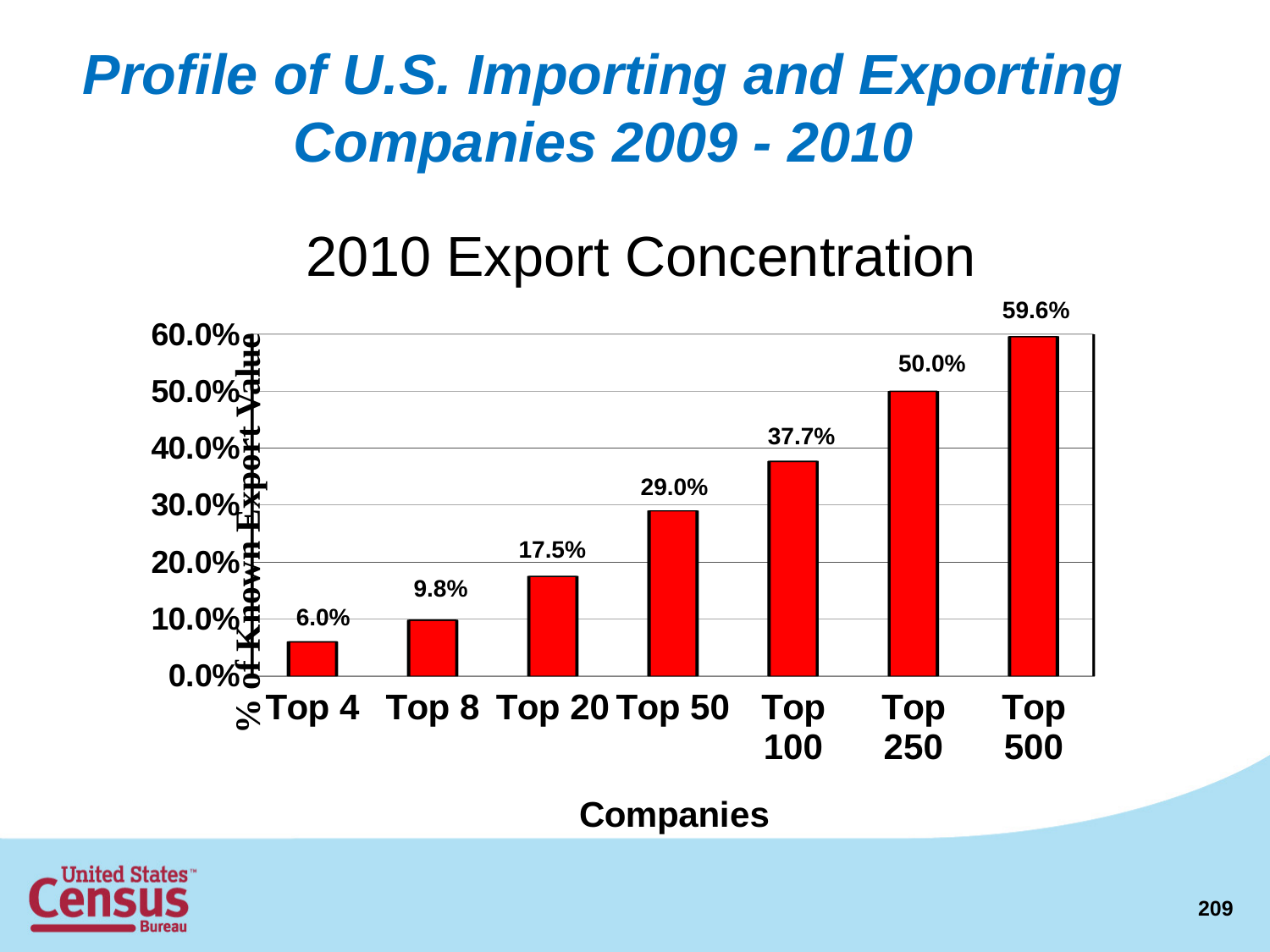
What is the difference between the values for Top 50 and Top 20? 11.5% Which category has the lowest value? Top 4 What is the value for Top 250 companies? 50.0% What is the difference between the values for Top 500 and Top 250? 9.6% Is the value for Top 100 greater or less than 40.0%? less What is the value for Top 4 companies? 6.0% Which is larger, the value for Top 8 or the value for Top 20? Top 20 Do the values rise or fall from Top 4 to Top 500? rise How many categories are shown on the x axis? 7 What kind of chart is shown? bar chart Which category has the highest value? Top 500 What is the value for Top 100 companies? 37.7%